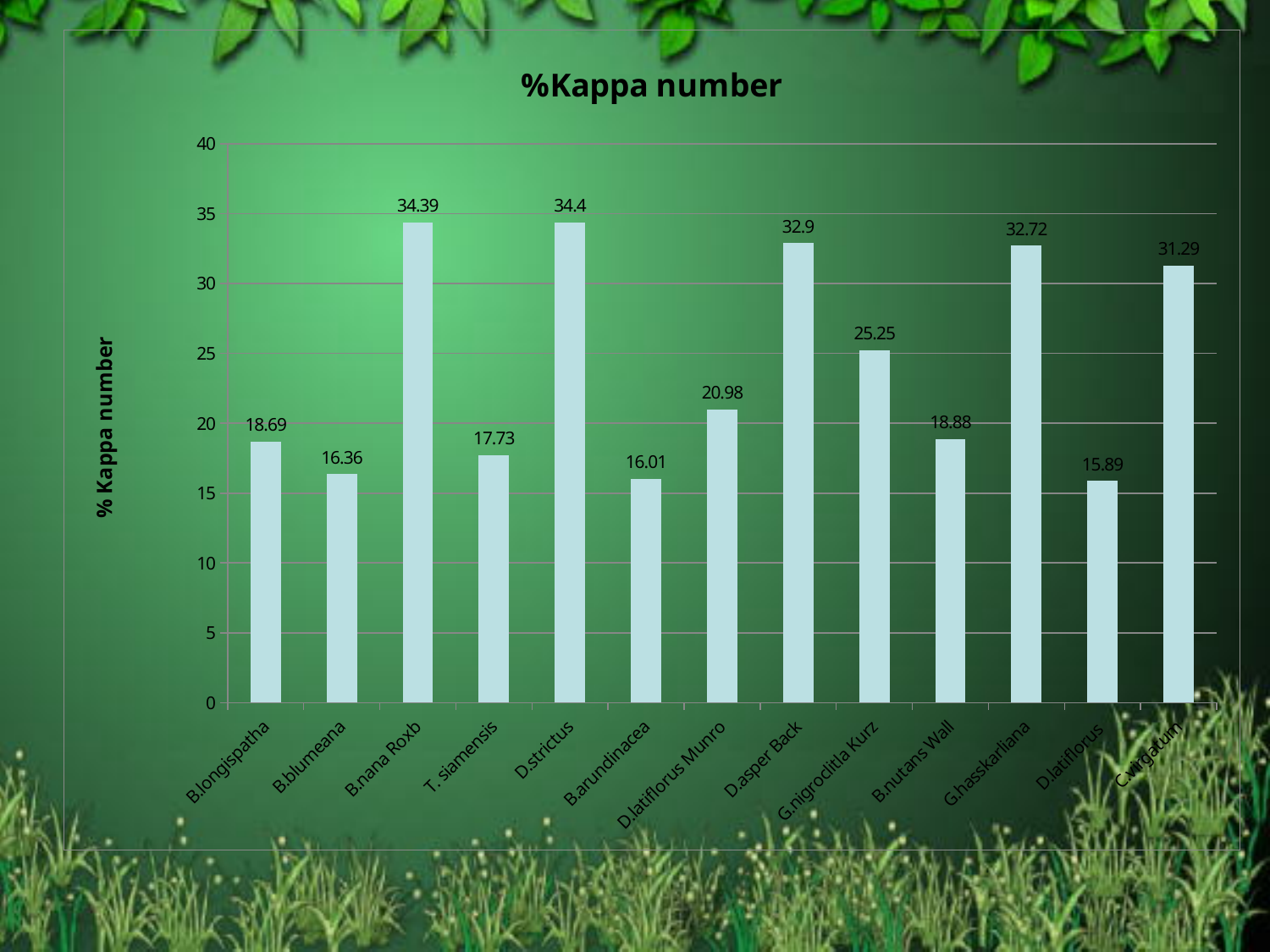
What is the value for B.arundinacea? 16.01 What is the value for C.virgatum? 31.29 Is the value for D.latiflorus greater or less than 20? less What is the difference between the values for G.hasskarliana and C.virgatum? 1.43 What kind of chart is shown on the slide? bar chart How many categories are shown on the x axis? 13 What is the value for D.latiflorus Munro? 20.98 Which has a larger value, B.longispatha or B.blumeana? B.longispatha What is the difference between the values for D.asper Back and B.nutans Wall? 14.02 Which has a larger value, T. siamensis or G.nigrocitla Kurz? G.nigrocitla Kurz What is the value for G.nigrocitla Kurz? 25.25 What is the value for B.nana Roxb? 34.39